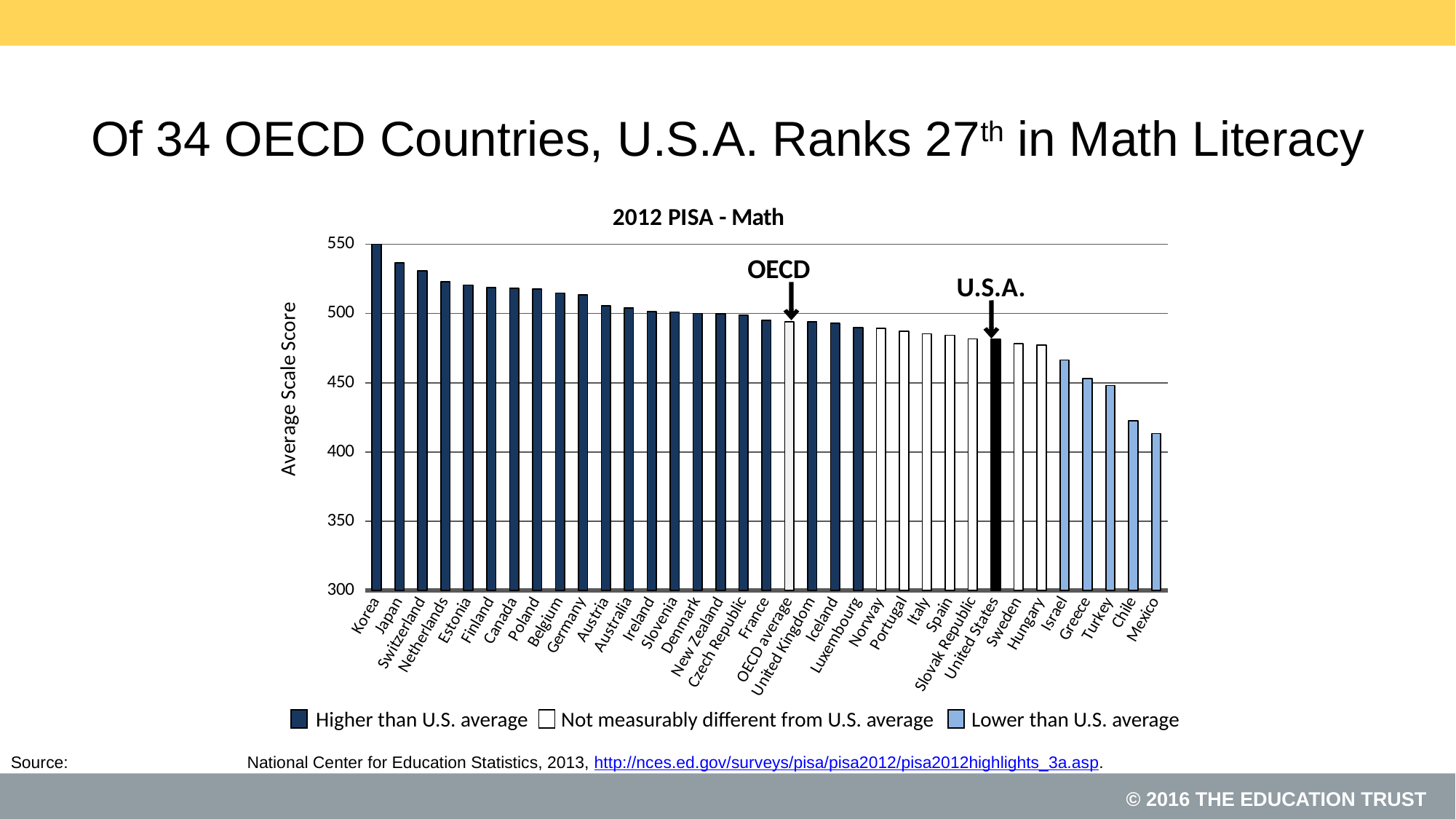
Which country has the lowest average scale score in the chart? Mexico What is the title of the chart? 2012 PISA - Math What kind of chart is shown on the slide? bar chart Which country has the highest average scale score in the chart? Korea Is the value for Korea greater or less than 500? greater Which has a higher average scale score, Japan or Chile? Japan Is the value for United States greater or less than 500? less Is the value for Greece greater or less than 500? less Which has a higher average scale score, Israel or Germany? Germany Do the values rise or fall moving from left to right along the x axis? fall How many entries does the legend list? 3